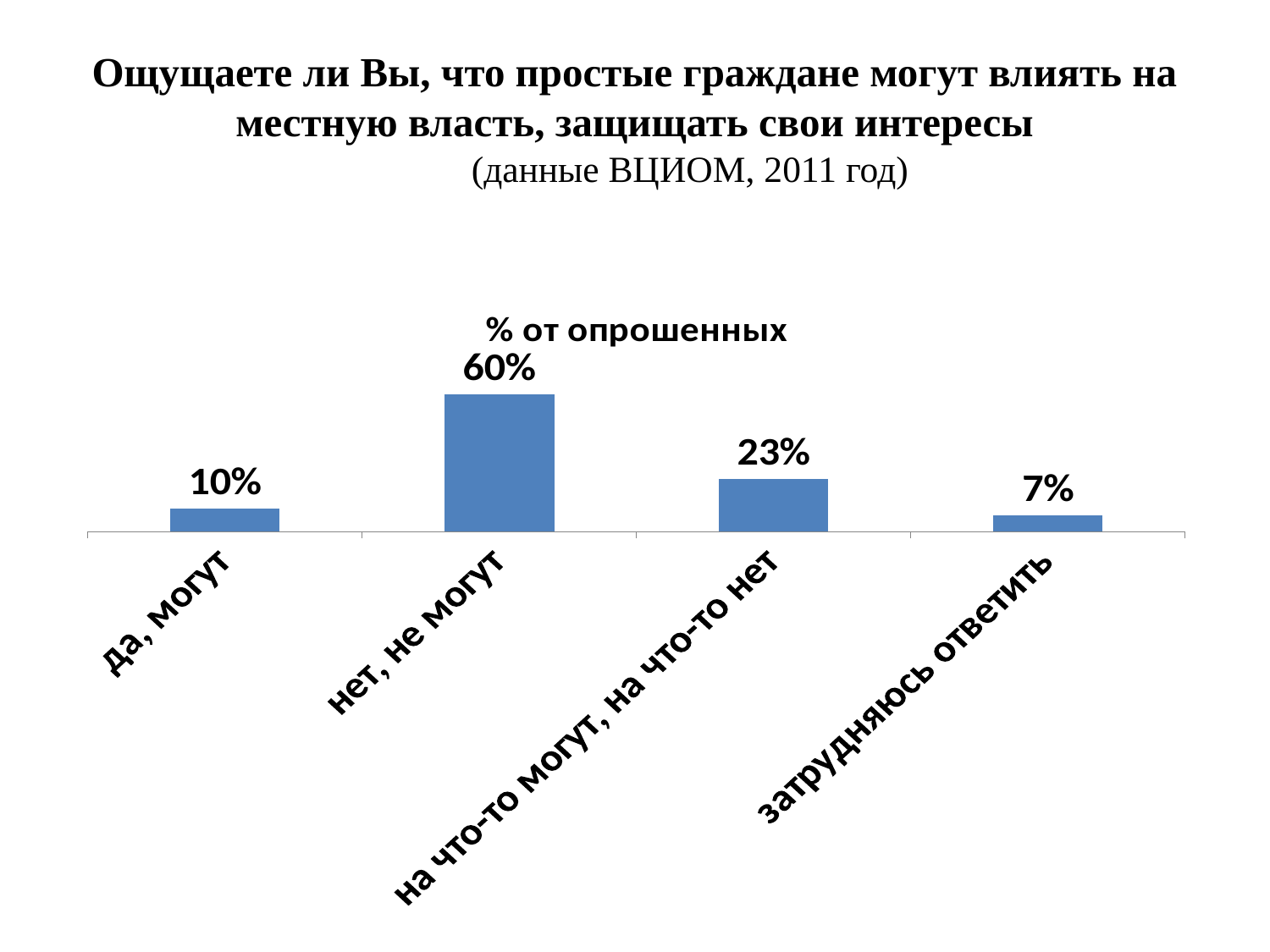
Which category has the highest value? нет, не могут Which is larger: the value for "да, могут" or the value for "на что-то могут, на что-то нет"? на что-то могут, на что-то нет How many categories are shown in the chart? 4 What is the value for "затрудняюсь ответить"? 7% What kind of chart is shown on the slide? bar chart What is the value for "на что-то могут, на что-то нет"? 23% What is the difference between the values for "нет, не могут" and "на что-то могут, на что-то нет"? 37% What is the difference between the values for "да, могут" and "затрудняюсь ответить"? 3% What is the title of the chart? % от опрошенных Which category has the lowest value? затрудняюсь ответить What is the value for "нет, не могут"? 60% What is the value for "да, могут"? 10%